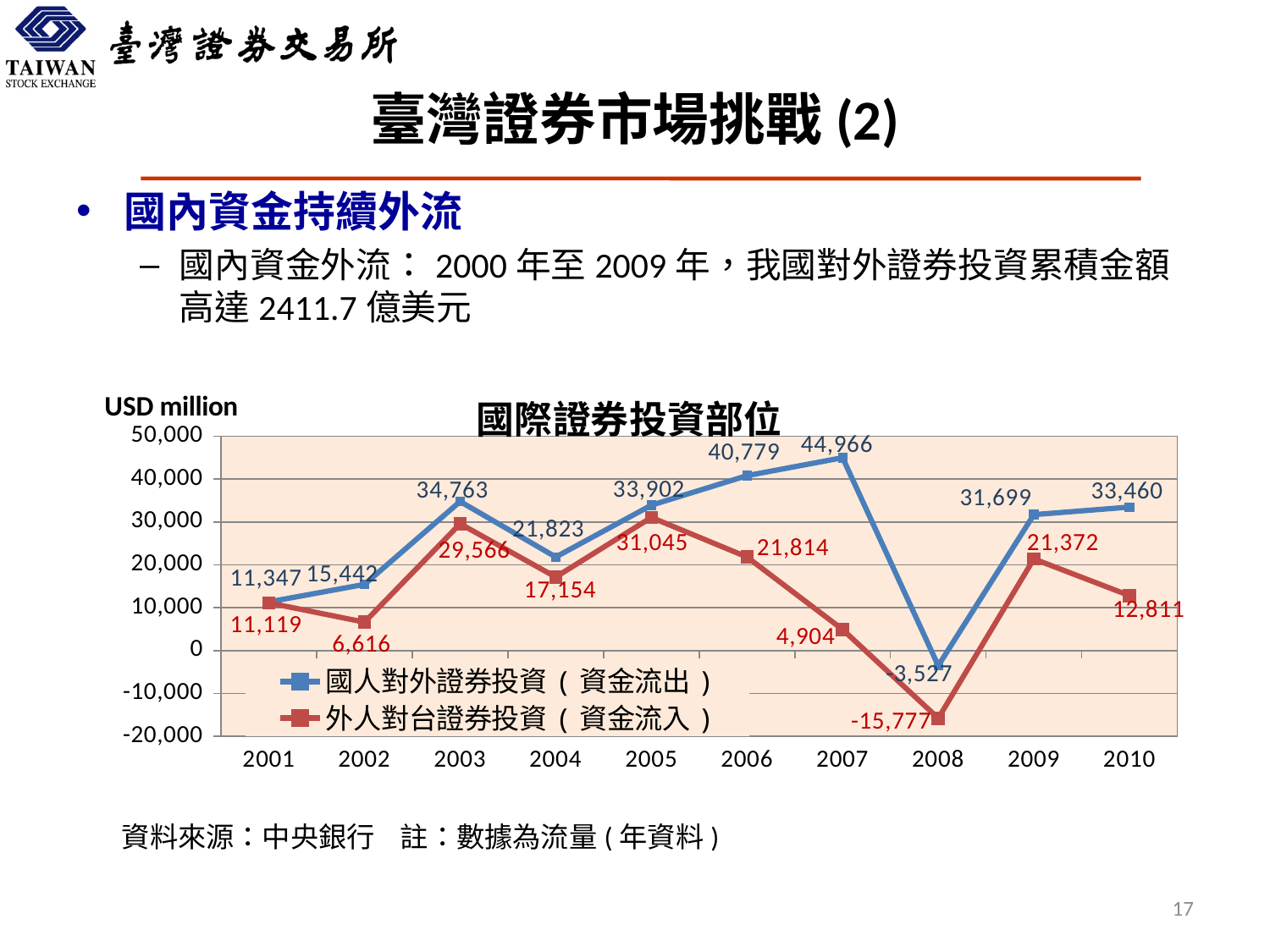
What is the value for 國人對外證券投資（資金流出） in 2007? 44,966 In which year is 外人對台證券投資（資金流入） lowest? 2008 Is the value for 國人對外證券投資（資金流出） in 2008 greater or less than 0? less What is the difference between 國人對外證券投資（資金流出） and 外人對台證券投資（資金流入） in 2010? 20,649 What is the difference between 國人對外證券投資（資金流出） and 外人對台證券投資（資金流入） in 2007? 40,062 What is the value for 外人對台證券投資（資金流入） in 2008? -15,777 What kind of chart is shown on the slide? line chart In 2003, which series has the larger value, 國人對外證券投資（資金流出） or 外人對台證券投資（資金流入）? 國人對外證券投資（資金流出） How many years are shown on the x axis of the chart? 10 What unit is indicated for the values in the chart? USD million In which year is 國人對外證券投資（資金流出） highest? 2007 How many series does the chart's legend list? 2